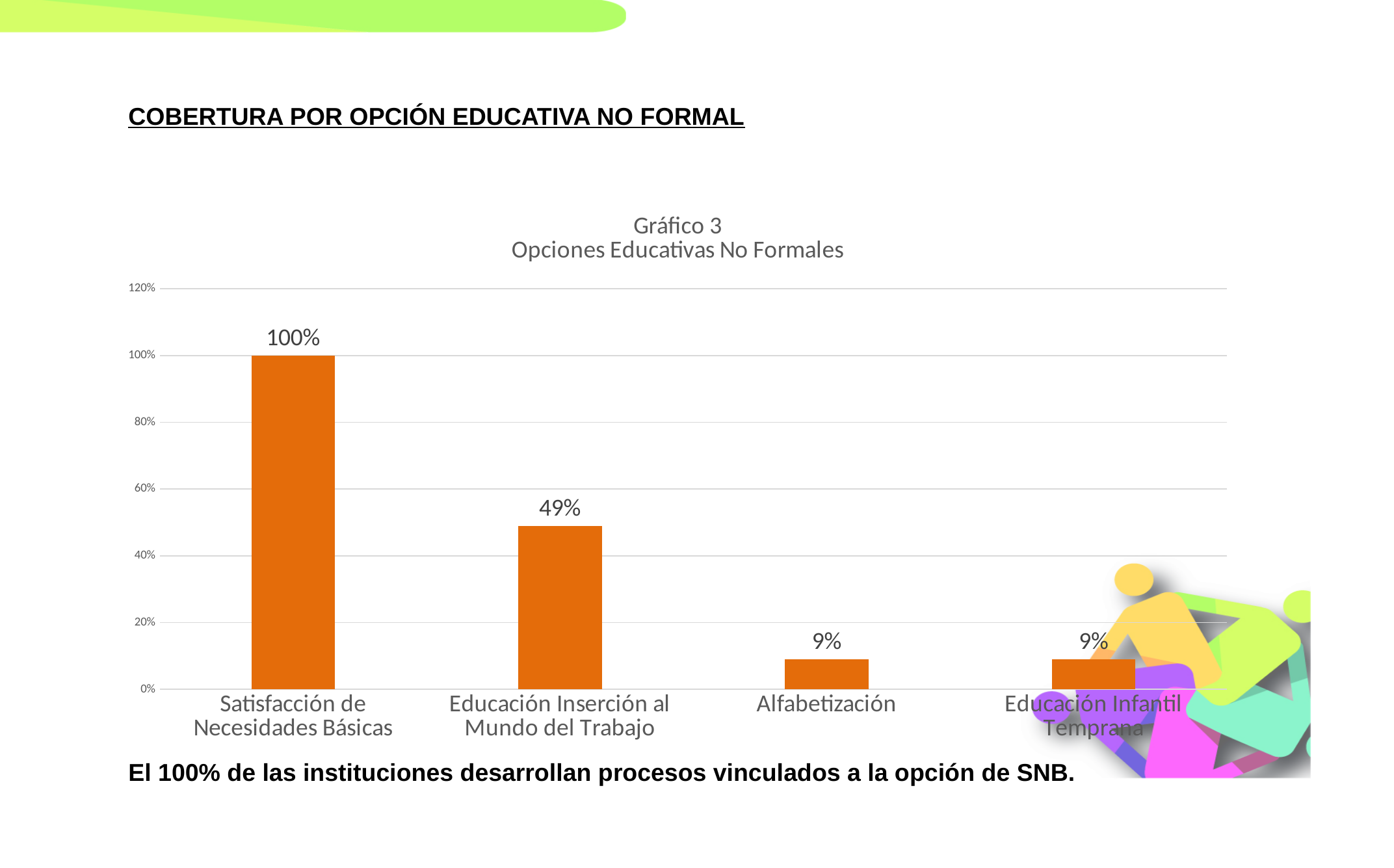
Which category has the highest value? Satisfacción de Necesidades Básicas What is the value for Satisfacción de Necesidades Básicas? 100% What is the title of the chart? Gráfico 3 Opciones Educativas No Formales What is the difference between the values for Satisfacción de Necesidades Básicas and Educación Inserción al Mundo del Trabajo? 51% What is the difference between the values for Educación Inserción al Mundo del Trabajo and Alfabetización? 40% What is the value for Educación Infantil Temprana? 9% What kind of chart is shown on the slide? bar chart Is the value for Educación Inserción al Mundo del Trabajo greater or less than 60%? less Which is larger, the value for Educación Inserción al Mundo del Trabajo or the value for Alfabetización? Educación Inserción al Mundo del Trabajo What is the value for Alfabetización? 9% How many categories are shown in the chart? 4 What is the value for Educación Inserción al Mundo del Trabajo? 49%